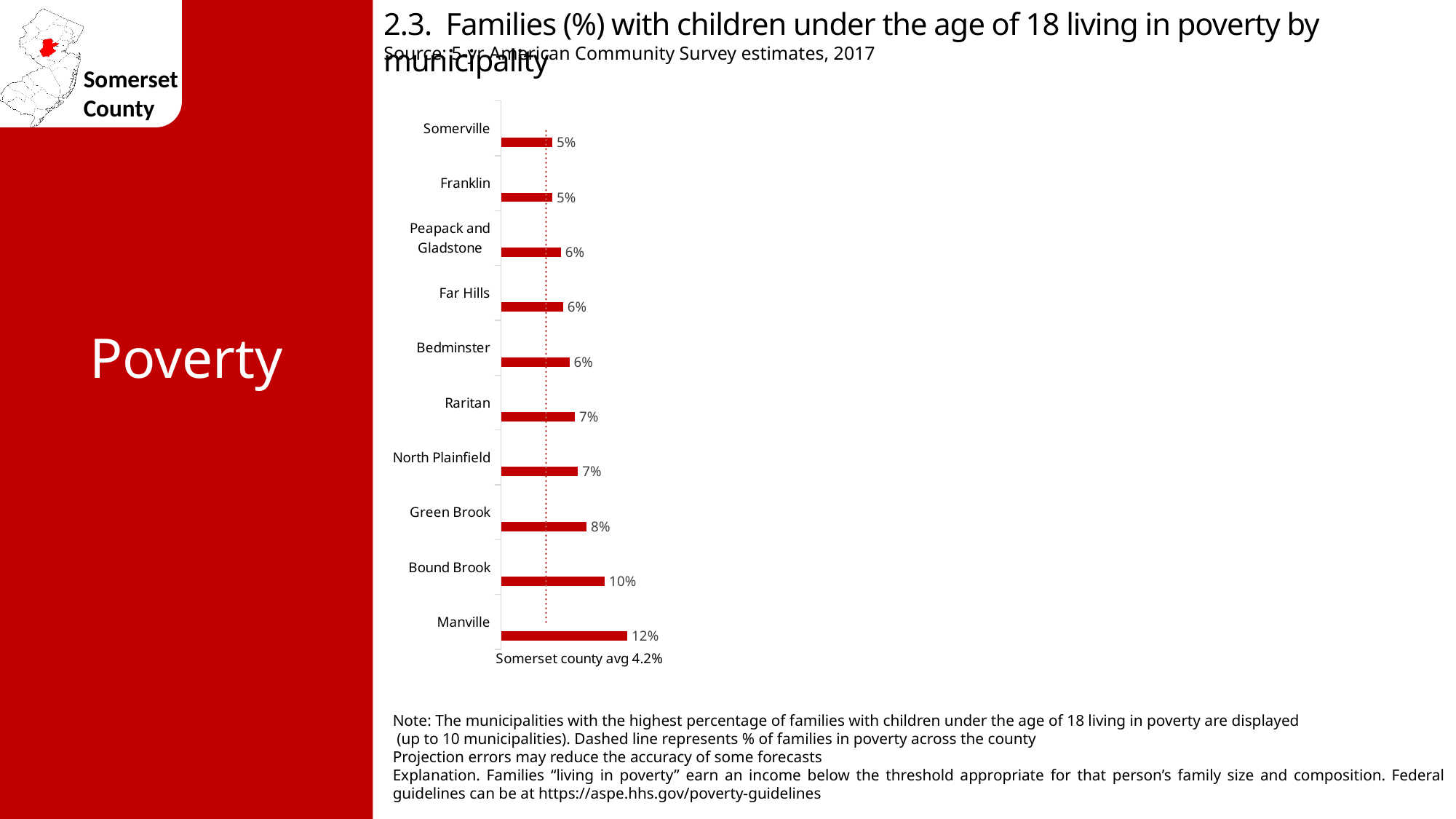
What type of chart is used on this slide? Bar chart Which has a higher value, Bound Brook or Raritan? Bound Brook How many municipalities are shown in the chart? 10 Which has a higher value, Green Brook or Far Hills? Green Brook Which municipality has the highest percentage of families with children under 18 living in poverty? Manville What is the value shown for Somerville? 5% What is the value shown for Green Brook? 8% What is the difference between the values for Manville and Bound Brook? 2% What is the difference between the values for Green Brook and Franklin? 3% What Somerset county average is marked by the dashed line in the chart? 4.2% What percentage of families with children under 18 live in poverty in Manville? 12% What is the value shown for Bound Brook? 10%